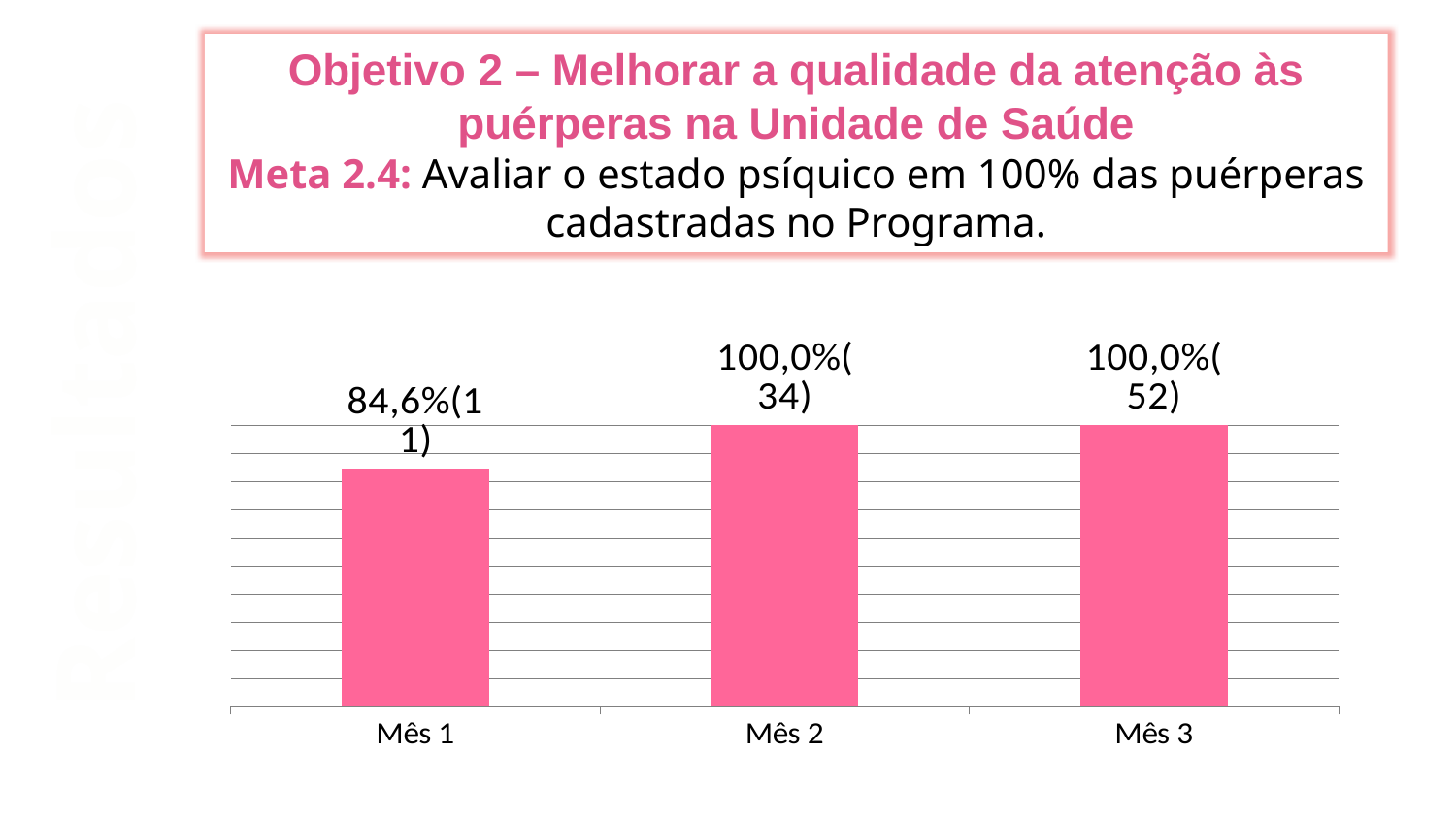
Do the values rise or fall from Mês 1 to Mês 3? Rise Which month has the lowest value? Mês 1 What is the value shown for Mês 2? 100,0%(34) What is the value shown for Mês 1? 84,6%(11) How many months (categories) are shown on the x axis? 3 What is the difference in percentage points between Mês 2 and Mês 1? 15,4 What percentage is shown for Mês 1? 84,6% What kind of chart is this? Bar chart What is the number in parentheses for Mês 3? 52 What is the value shown for Mês 3? 100,0%(52) Which is larger, the value for Mês 1 or the value for Mês 2? Mês 2 Which months reached 100,0%? Mês 2 and Mês 3